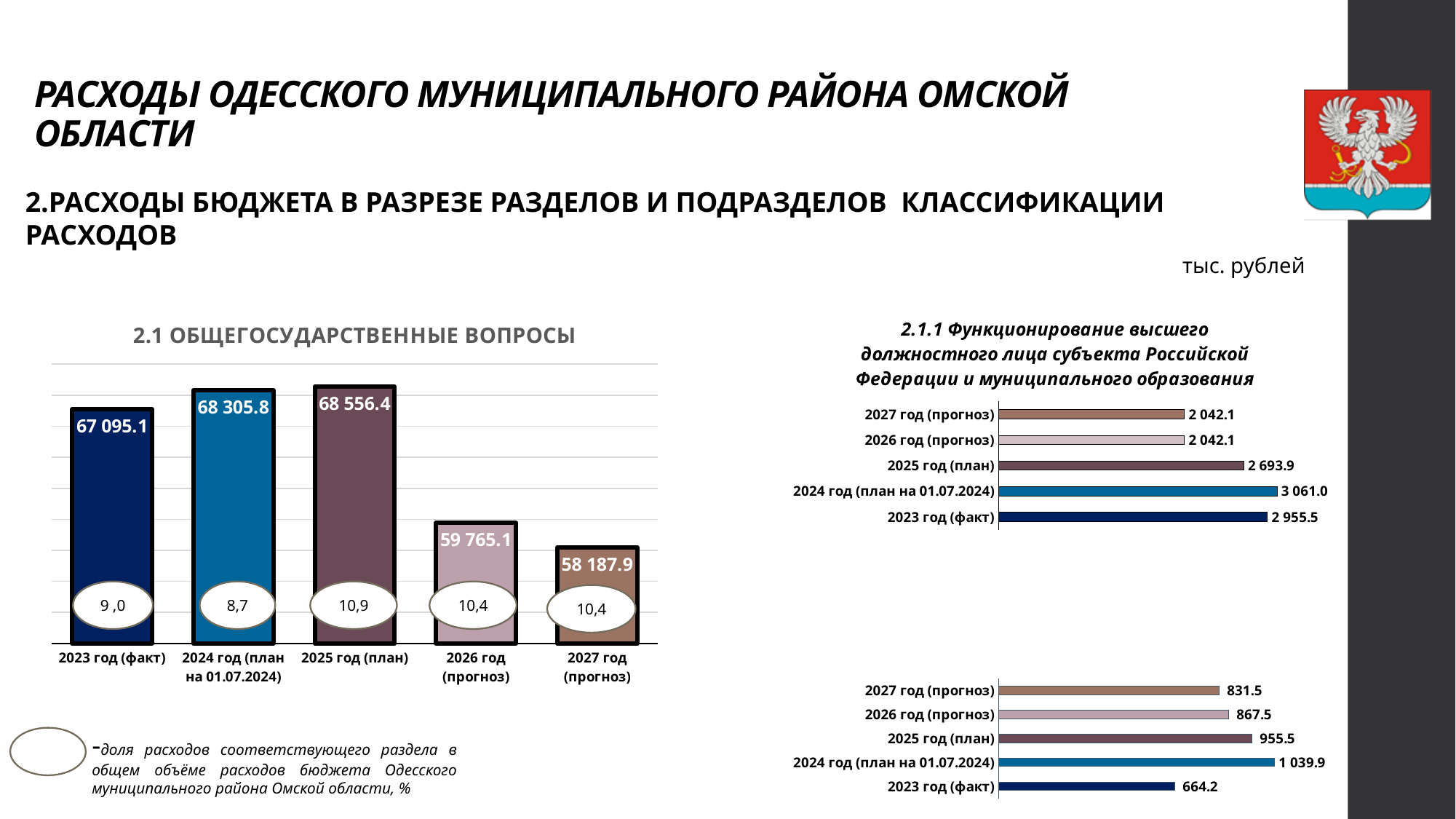
In the chart '2.1.1 Функционирование высшего должностного лица...', what is the value for 2024 год (план на 01.07.2024)? 3 061.0 In the chart '2.1 ОБЩЕГОСУДАРСТВЕННЫЕ ВОПРОСЫ', which year has the highest value? 2025 год (план) In the chart '2.1 ОБЩЕГОСУДАРСТВЕННЫЕ ВОПРОСЫ', how many bars are plotted? 5 In the chart '2.1.1 Функционирование высшего должностного лица...', which year has the lowest value? 2026 год (прогноз) and 2027 год (прогноз) What kind of chart is '2.1.1 Функционирование высшего должностного лица субъекта Российской Федерации и муниципального образования'? bar chart In the chart '2.1 ОБЩЕГОСУДАРСТВЕННЫЕ ВОПРОСЫ', which year has the lowest value? 2027 год (прогноз) In the chart '2.1 ОБЩЕГОСУДАРСТВЕННЫЕ ВОПРОСЫ', what is the difference between the values for 2026 год (прогноз) and 2027 год (прогноз)? 1 577.2 In the bottom-right chart, what is the value for 2023 год (факт)? 664.2 In the bottom-right chart, which year has the highest value? 2024 год (план на 01.07.2024) In the chart '2.1.1 Функционирование высшего должностного лица...', what is the difference between 2024 год (план на 01.07.2024) and 2025 год (план)? 367.1 In the chart '2.1 ОБЩЕГОСУДАРСТВЕННЫЕ ВОПРОСЫ', what is the value for 2023 год (факт)? 67 095.1 In the chart '2.1 ОБЩЕГОСУДАРСТВЕННЫЕ ВОПРОСЫ', what share figure is shown in the circle on the 2025 год (план) bar? 10,9